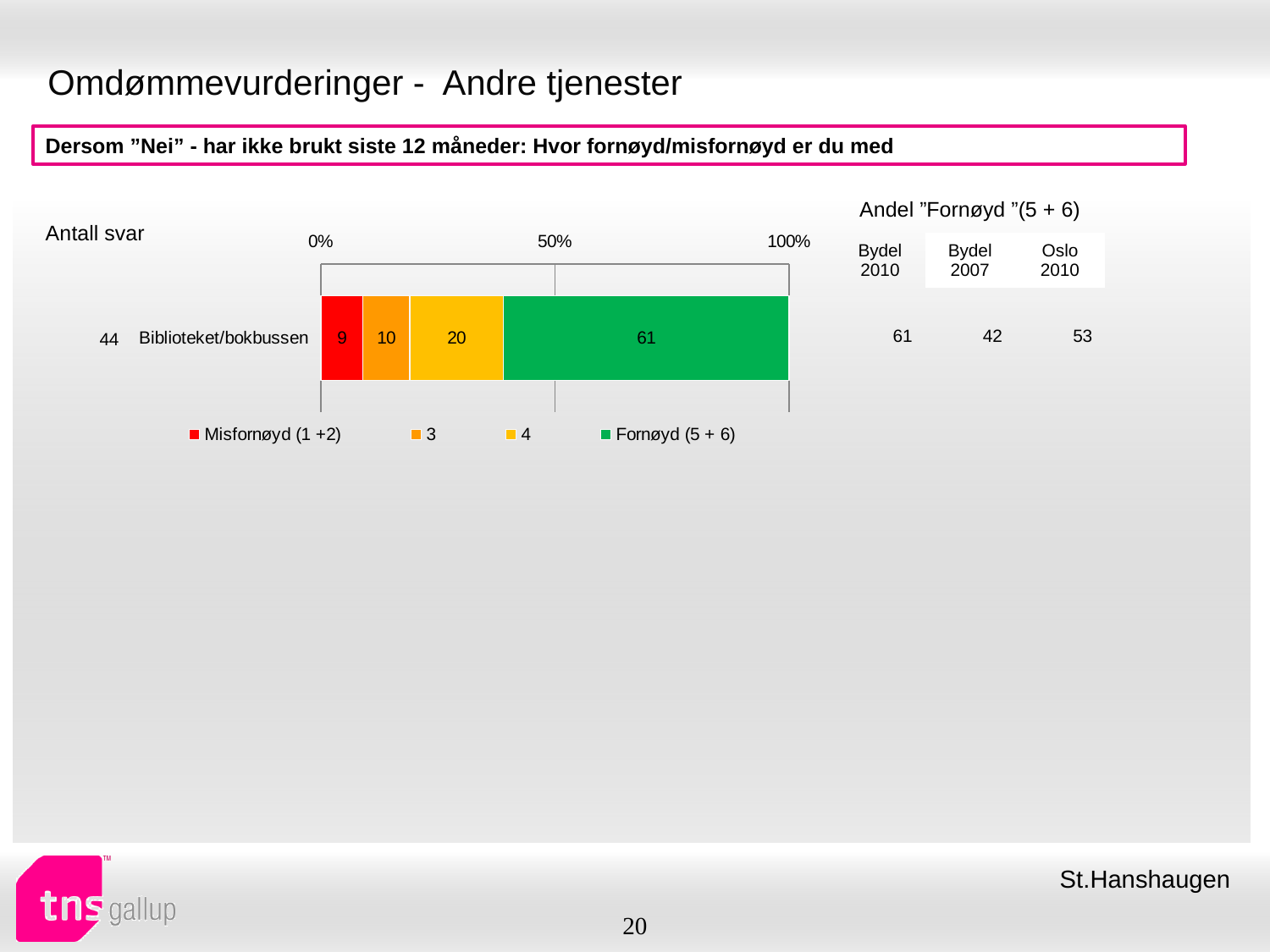
Which is larger for Biblioteket/bokbussen, the "3" segment or the "4" segment? 4 How many series does the legend list? 4 What is the total of the stacked bar for Biblioteket/bokbussen? 100 What is the value of the "Fornøyd (5 + 6)" segment for Biblioteket/bokbussen? 61 How many categories are plotted in the chart? 1 Which segment of the Biblioteket/bokbussen bar has the smallest value? Misfornøyd (1 +2) What is the difference between the "Fornøyd (5 + 6)" segment and the "4" segment for Biblioteket/bokbussen? 41 What is the value of the "4" segment for Biblioteket/bokbussen? 20 What kind of chart is shown on the slide? Stacked bar chart Which segment of the Biblioteket/bokbussen bar has the largest value? Fornøyd (5 + 6) What is the value of the "3" segment for Biblioteket/bokbussen? 10 What is the value of the "Misfornøyd (1 +2)" segment for Biblioteket/bokbussen? 9